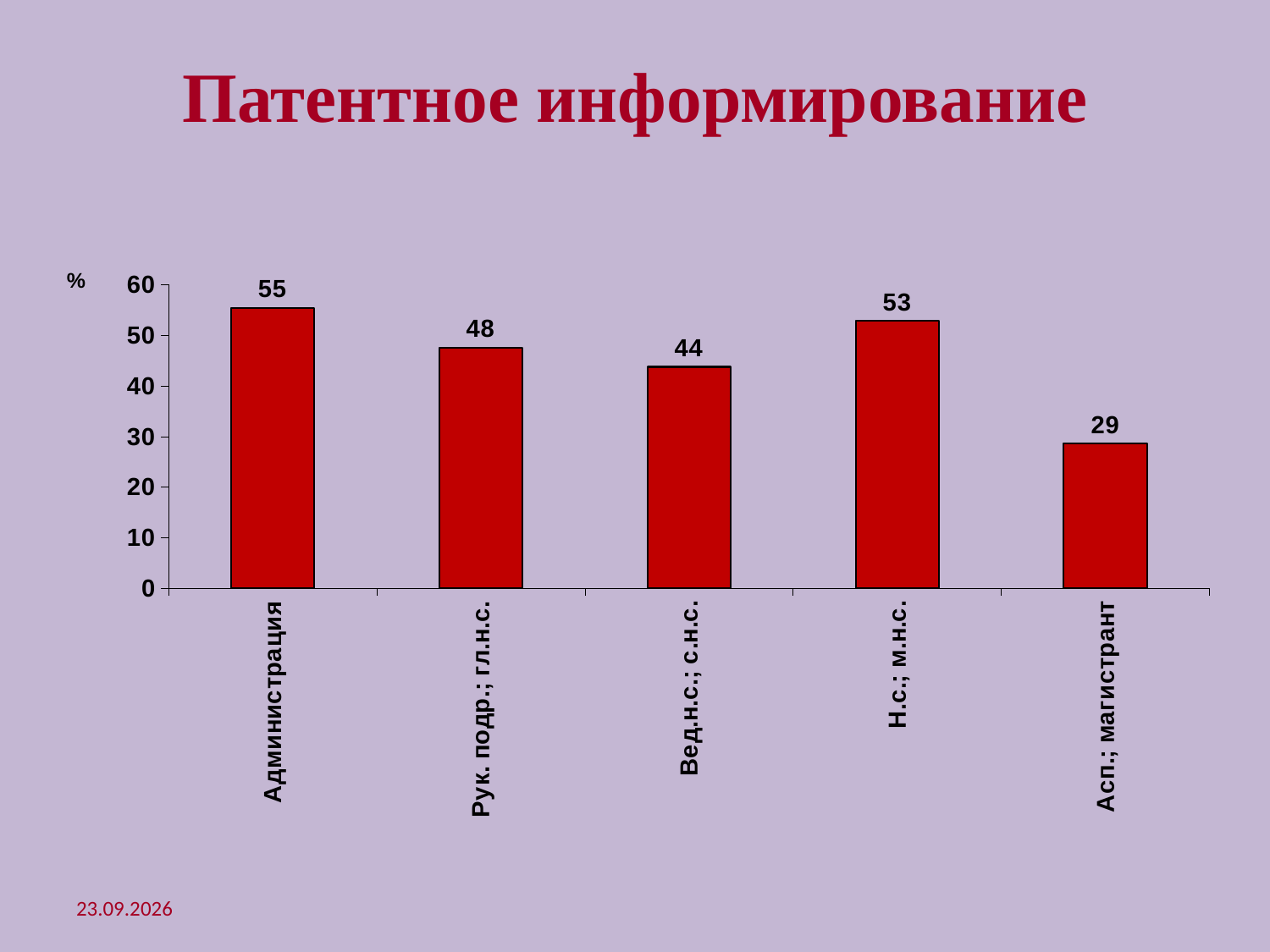
What is the value for Вед.н.с.; с.н.с.? 44 Which is larger, the value for Рук. подр.; гл.н.с. or the value for Н.с.; м.н.с.? Н.с.; м.н.с. What is the value for Н.с.; м.н.с.? 53 What is the difference between the values for Администрация and Асп.; магистрант? 26 What is the value for Асп.; магистрант? 29 How many categories are shown in the chart? 5 What is the title of the slide? Патентное информирование What is the value for Администрация? 55 Which category has the highest value? Администрация What is the value for Рук. подр.; гл.н.с.? 48 What kind of chart is shown on the slide? bar chart Which category has the lowest value? Асп.; магистрант